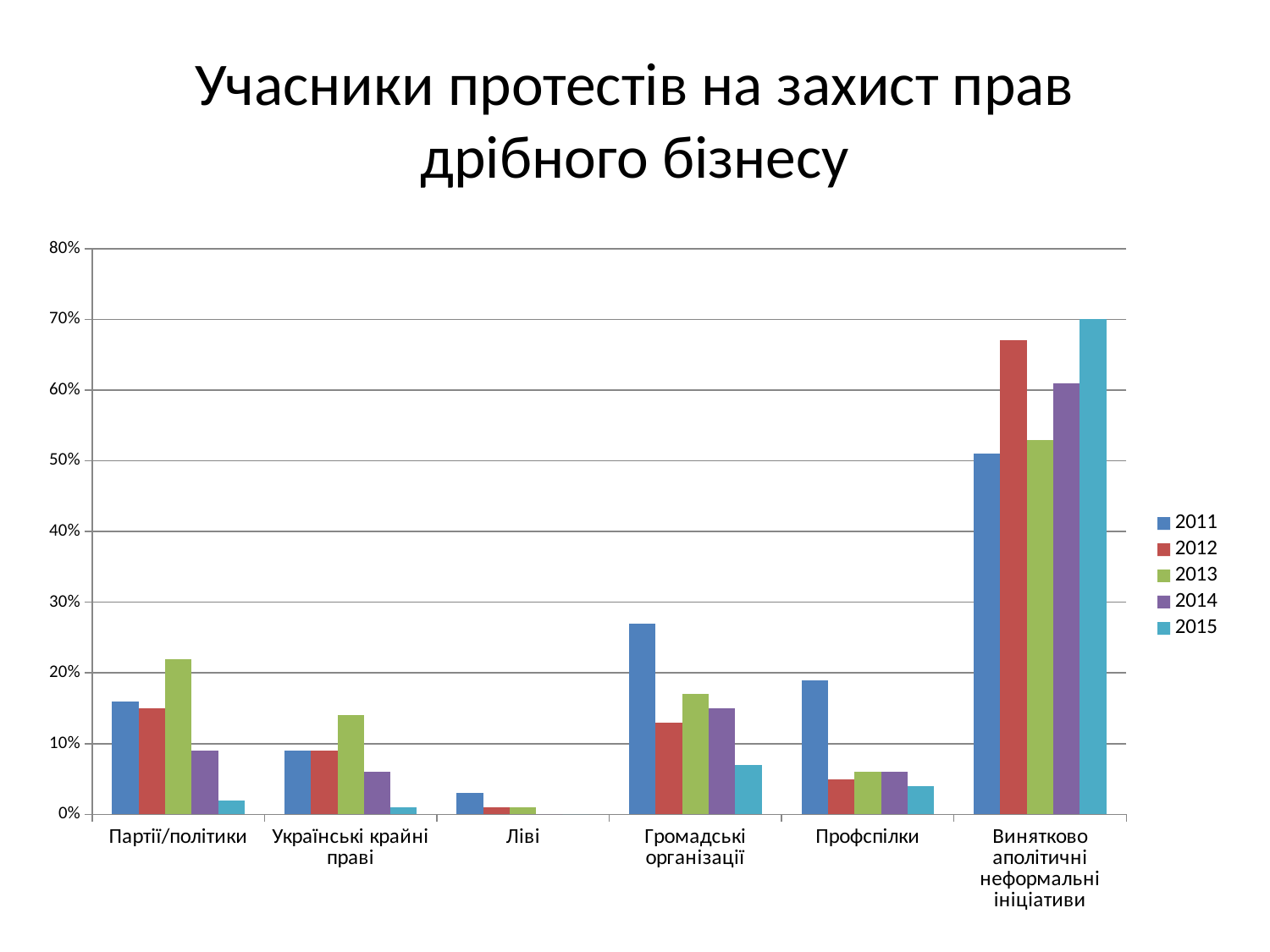
Is the 2015 value for Винятково аполітичні неформальні ініціативи greater or less than 60%? greater Which category has the lowest value for 2011? Ліві Which year has the highest value for Винятково аполітичні неформальні ініціативи? 2015 Is the 2012 value for Профспілки greater or less than 10%? less What entries are listed in the legend? 2011, 2012, 2013, 2014, 2015 Is the 2011 value for Громадські організації greater or less than 20%? greater For Винятково аполітичні неформальні ініціативи, which is larger: the 2012 value or the 2014 value? 2012 What kind of chart is shown on the slide? Bar chart How many series does the legend list? 5 Which category has the highest value for 2015? Винятково аполітичні неформальні ініціативи For Партії/політики, which is larger: the 2011 value or the 2013 value? 2013 How many categories are shown on the x axis? 6